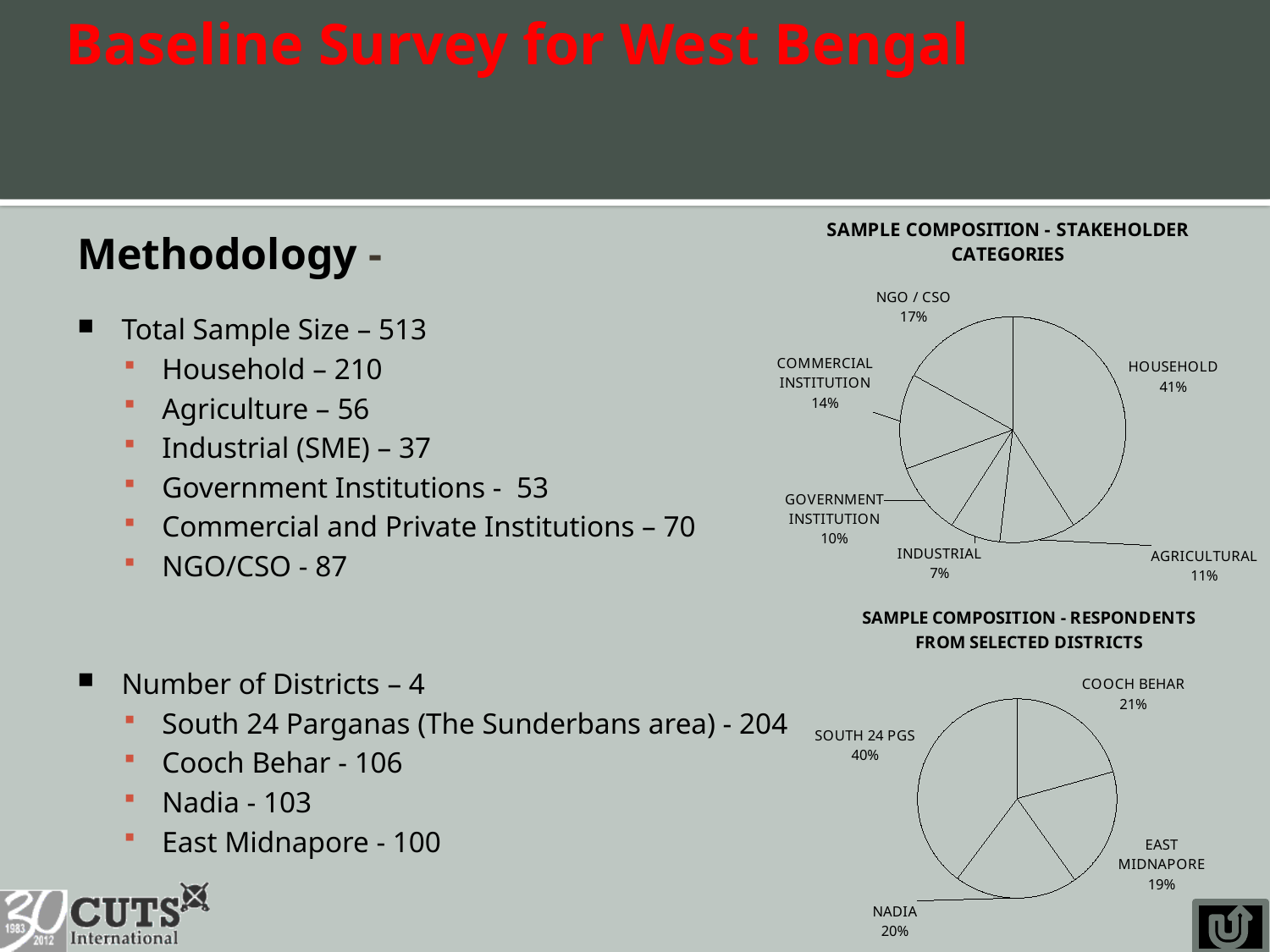
In the 'Sample Composition - Stakeholder Categories' chart, which category has the largest share? Household In the 'Sample Composition - Respondents from Selected Districts' chart, what share does East Midnapore have? 19% In the 'Sample Composition - Stakeholder Categories' chart, what share does Household have? 41% In the 'Sample Composition - Respondents from Selected Districts' chart, which district has the largest share? South 24 PGS In the 'Sample Composition - Stakeholder Categories' chart, which category has the smallest share? Industrial What type of chart is the 'Sample Composition - Stakeholder Categories' chart? Pie chart In the 'Sample Composition - Stakeholder Categories' chart, what is the difference between the Commercial Institution share and the Government Institution share? 4% In the 'Sample Composition - Respondents from Selected Districts' chart, what is the difference between the Cooch Behar share and the Nadia share? 1% In the 'Sample Composition - Stakeholder Categories' chart, what share does NGO / CSO have? 17% In the 'Sample Composition - Respondents from Selected Districts' chart, what share does South 24 PGS have? 40% In the 'Sample Composition - Stakeholder Categories' chart, how many categories are shown? 6 In the 'Sample Composition - Respondents from Selected Districts' chart, how many districts are shown? 4